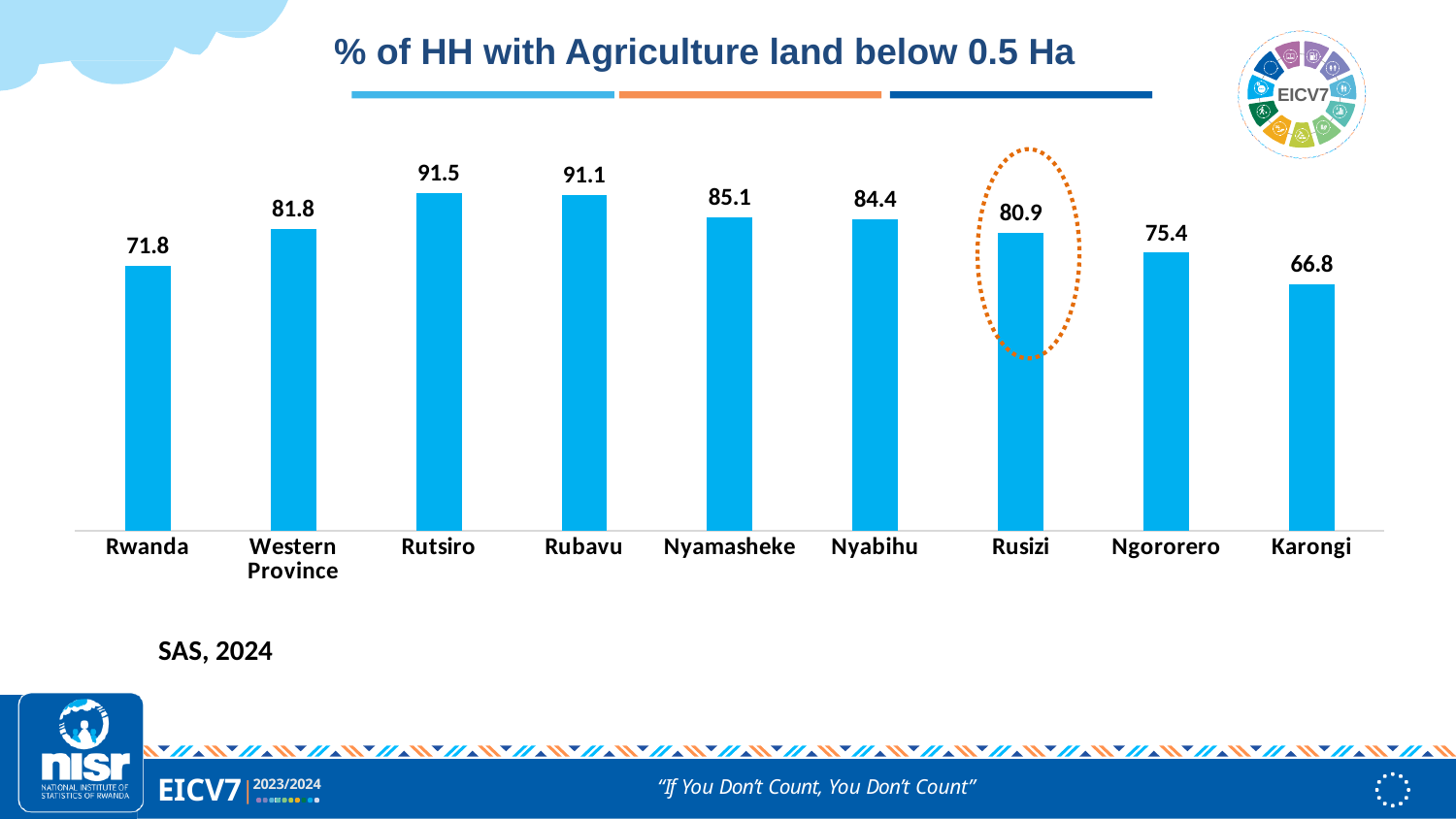
What is the value for Karongi? 66.8 What is the difference between the values for Western Province and Rwanda? 10 What is the value for Rwanda? 71.8 Which bar is circled with a dotted orange outline? Rusizi What kind of chart is shown on the slide? Bar chart What is the title of the chart? % of HH with Agriculture land below 0.5 Ha What is the value for Rusizi? 80.9 Which category has the highest value? Rutsiro Which is larger, the value for Nyamasheke or the value for Ngororero? Nyamasheke How many categories are shown on the chart? 9 What is the difference between the values for Rutsiro and Karongi? 24.7 Which category has the lowest value? Karongi